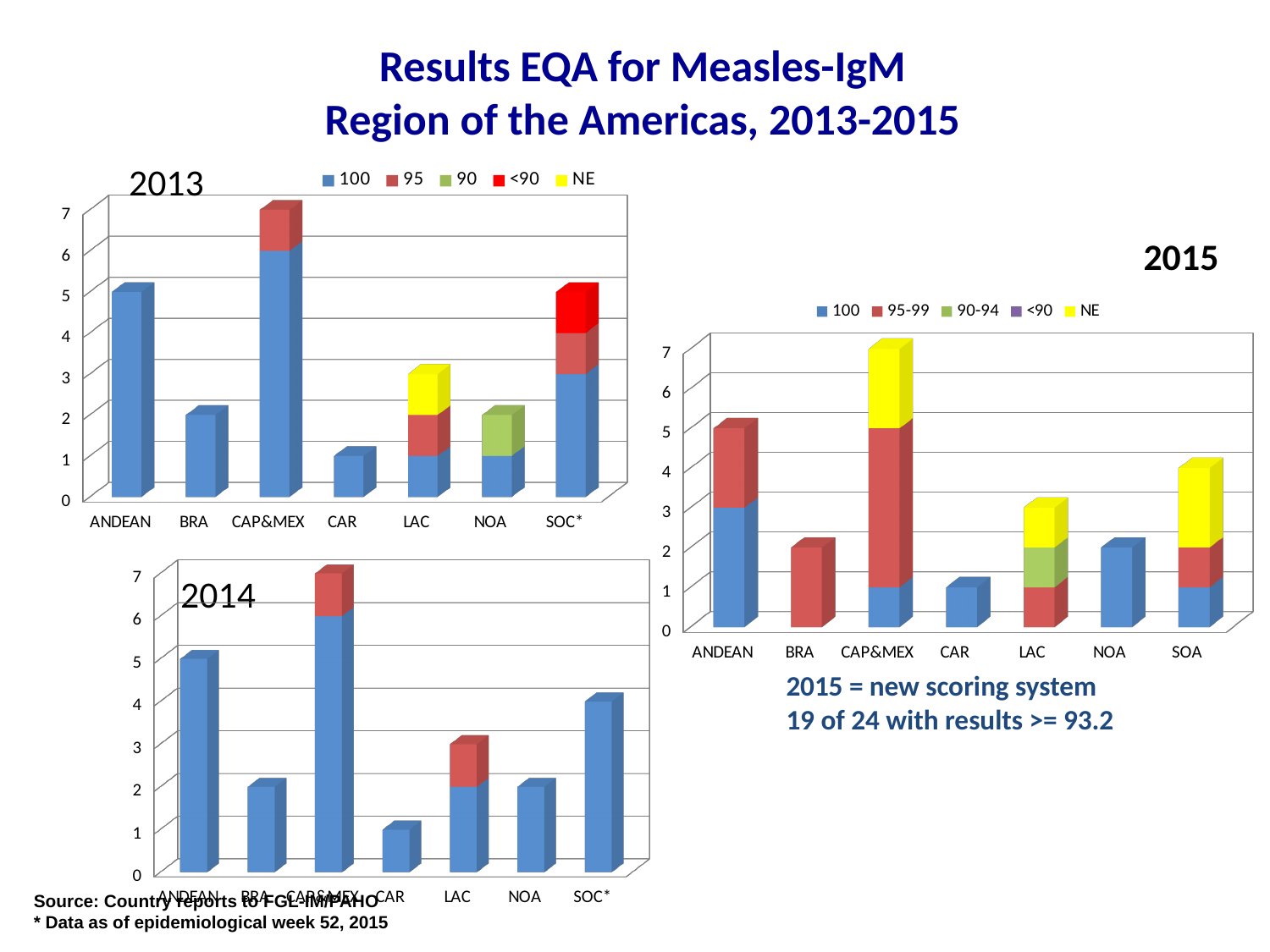
In the 2015 chart, what is the difference between the total heights of the CAP&MEX and CAR bars? 6 In the 2013 chart, how many series does the legend list? 5 In the 2014 chart, which category has the highest bar? CAP&MEX What kind of chart is the 2015 chart? Stacked bar chart In the 2015 chart, is the ANDEAN bar or the SOA bar taller? ANDEAN In the 2013 chart, which category has the lowest bar? CAR In the 2013 chart, what is the value of the 100 segment for ANDEAN? 5 In the 2013 chart, what is the total height of the CAP&MEX bar? 7 In the 2014 chart, how many categories are shown on the x axis? 7 In the 2015 chart, what is the total height of the CAP&MEX bar? 7 In the 2015 chart, what is the value of the NE segment for SOA? 2 In the 2014 chart, what is the total height of the SOC* bar? 4